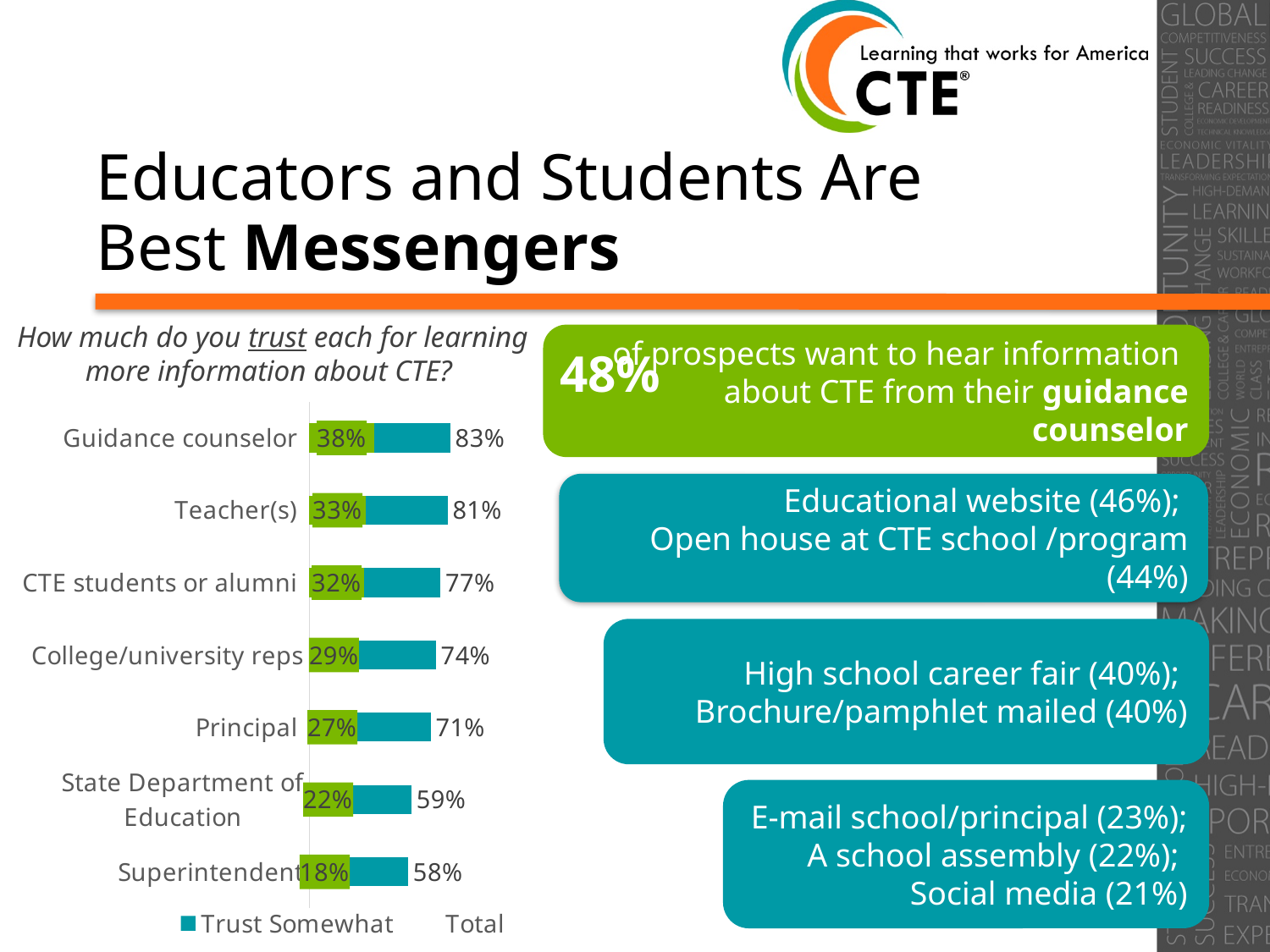
What type of chart is shown on the slide? Bar chart How many series does the chart legend list? 2 Which category has the highest Total value? Guidance counselor What is the difference between the Total values for Guidance counselor and Superintendent? 25 percentage points What is the Total value for Guidance counselor? 83% How many categories are shown in the bar chart? 7 Which category has the lowest Total value? Superintendent What is the Total value for Superintendent? 58% Which has a higher Total value, Principal or College/university reps? College/university reps What question is the chart answering, according to the italic text above it? How much do you trust each for learning more information about CTE? What is the green-highlighted value shown for Teacher(s)? 33% What is the Total value for State Department of Education? 59%